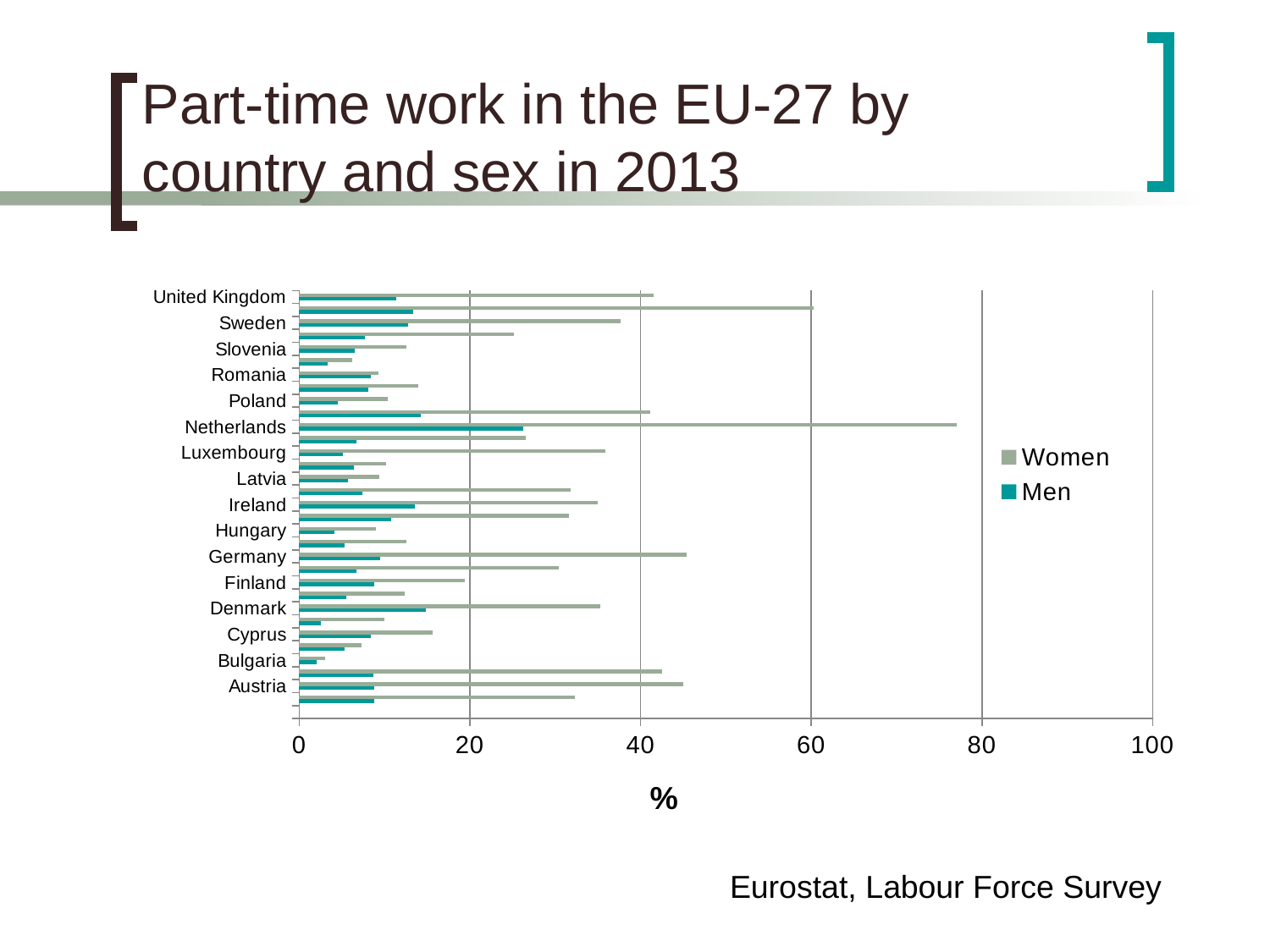
What label is shown on the horizontal axis? % Which country has the lowest part-time rate for women? Bulgaria Is the value for women in Germany greater or less than 40? greater Which country has the highest part-time rate for men? Netherlands Is the value for women in the Netherlands greater or less than 60? greater What kind of chart is shown on the slide? bar chart Is the value for women in Luxembourg greater or less than 40? less Which is larger, the value for women in the Netherlands or the value for women in Germany? Netherlands Which country has the highest part-time rate for women? Netherlands Which is larger, the value for women in Denmark or the value for women in Finland? Denmark How many series does the legend list? 2